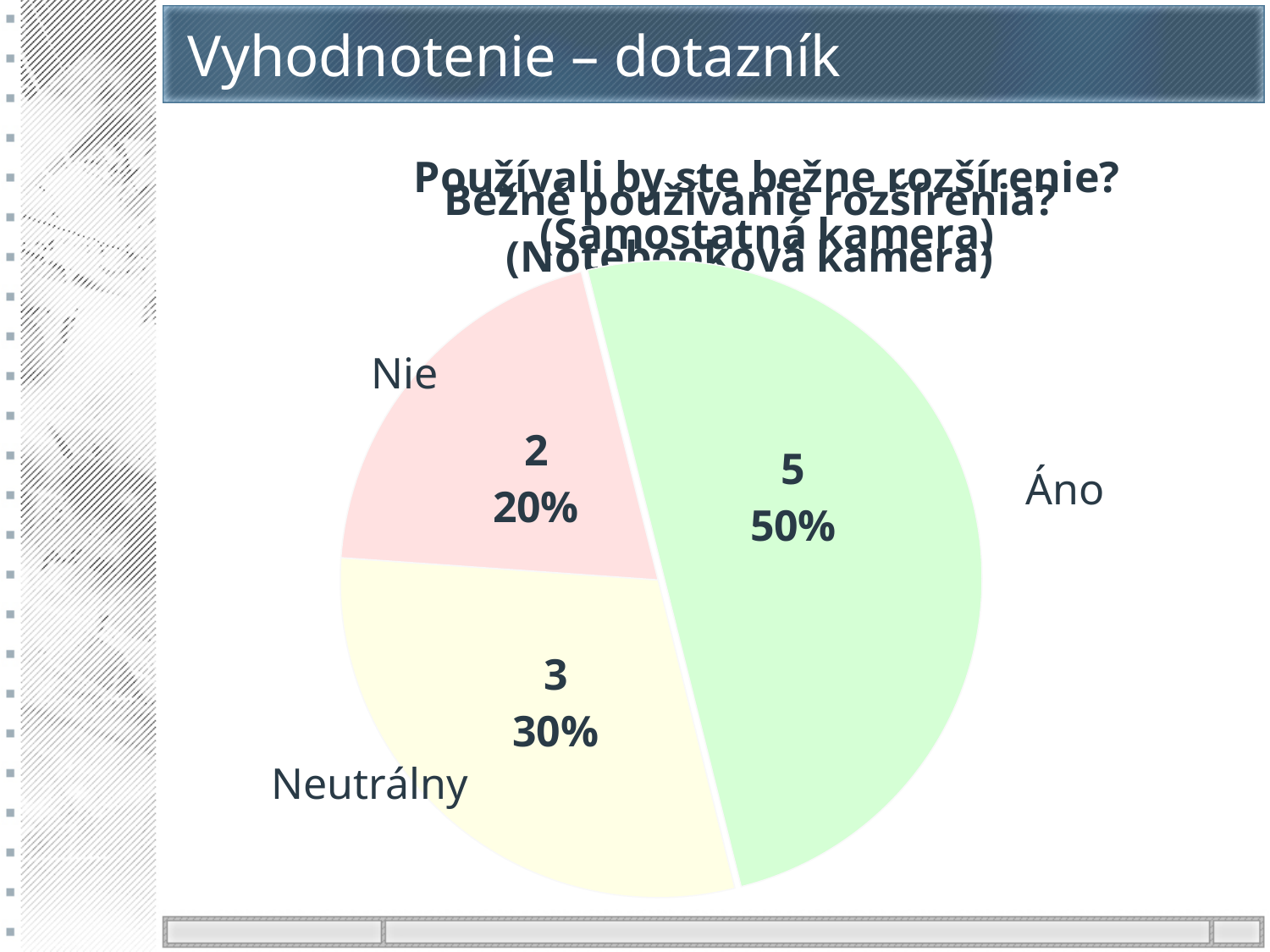
What kind of chart is shown on the slide? pie chart Which is larger, the value for Neutrálny or the value for Nie? Neutrálny How many slices does the pie chart have? 3 What is the total of the values shown on the pie chart? 10 What percentage is shown for the Nie slice? 20% Which slice of the pie chart is the largest? Áno What percentage is shown for the Neutrálny slice? 30% Which slice of the pie chart is the smallest? Nie What is the difference between the values for Áno and Nie? 3 What value is shown for the Nie slice? 2 What share of the pie does the Áno slice represent? 50% What value is shown for the Áno slice? 5